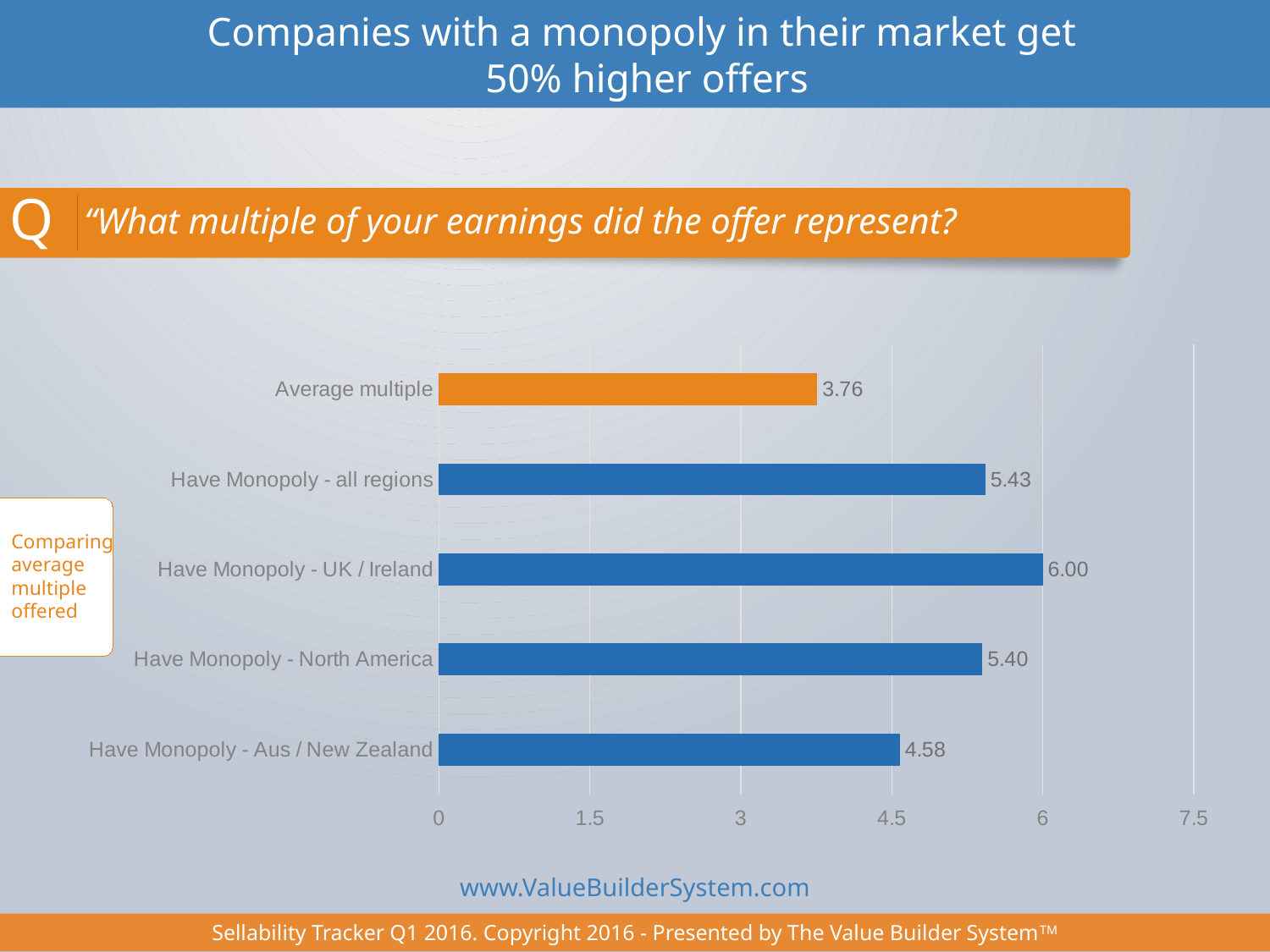
What is the value for Have Monopoly - Aus / New Zealand? 4.58 What is the difference between Have Monopoly - all regions and Average multiple? 1.67 What is the difference between Have Monopoly - UK / Ireland and Have Monopoly - Aus / New Zealand? 1.42 Is the value for Have Monopoly - North America greater or less than 4.5? greater What is the value for Have Monopoly - all regions? 5.43 How many categories are shown in the chart? 5 Which category has the highest value? Have Monopoly - UK / Ireland What is the value for Have Monopoly - UK / Ireland? 6.00 What kind of chart is shown on the slide? Bar chart Which category has the lowest value? Average multiple Which is larger, Have Monopoly - North America or Have Monopoly - Aus / New Zealand? Have Monopoly - North America What is the value for Average multiple? 3.76